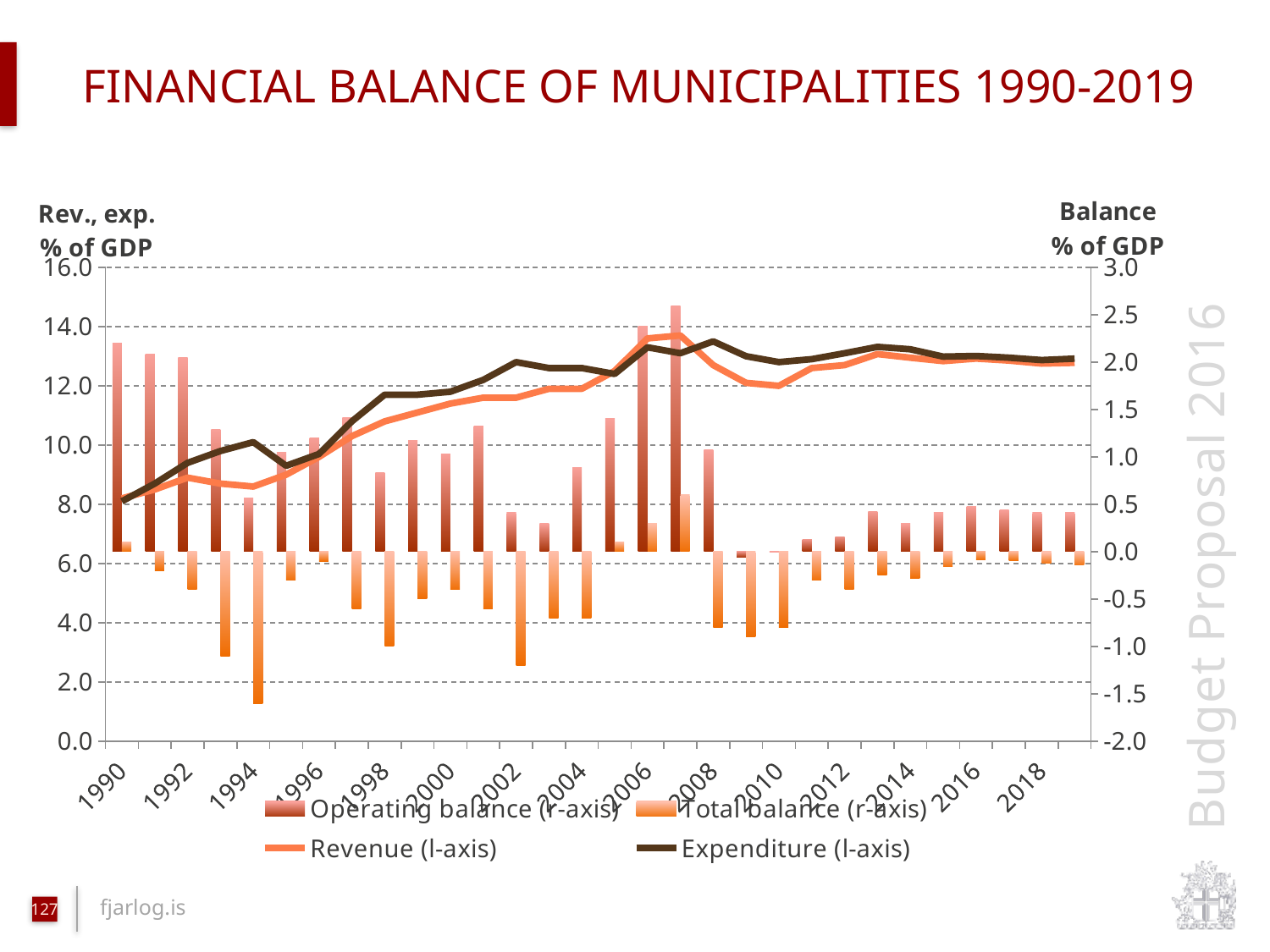
In which year is the Total balance (r-axis) bar lowest? 1994 Is the Total balance (r-axis) value for 1994 greater or less than -1.0? less What is the title of the chart? FINANCIAL BALANCE OF MUNICIPALITIES 1990-2019 How many years does the chart cover? 30 Is the Expenditure (l-axis) value for 1990 greater or less than 10.0? less Is the Operating balance (r-axis) value for 2007 greater or less than 2.0? greater How many series does the legend list? 4 In which year is the Operating balance (r-axis) bar highest? 2007 Does the Expenditure (l-axis) line rise or fall between 1990 and 2007? rise In 2002, which is larger: Revenue (l-axis) or Expenditure (l-axis)? Expenditure (l-axis) What kind of chart is shown on the slide? A combined bar and line chart